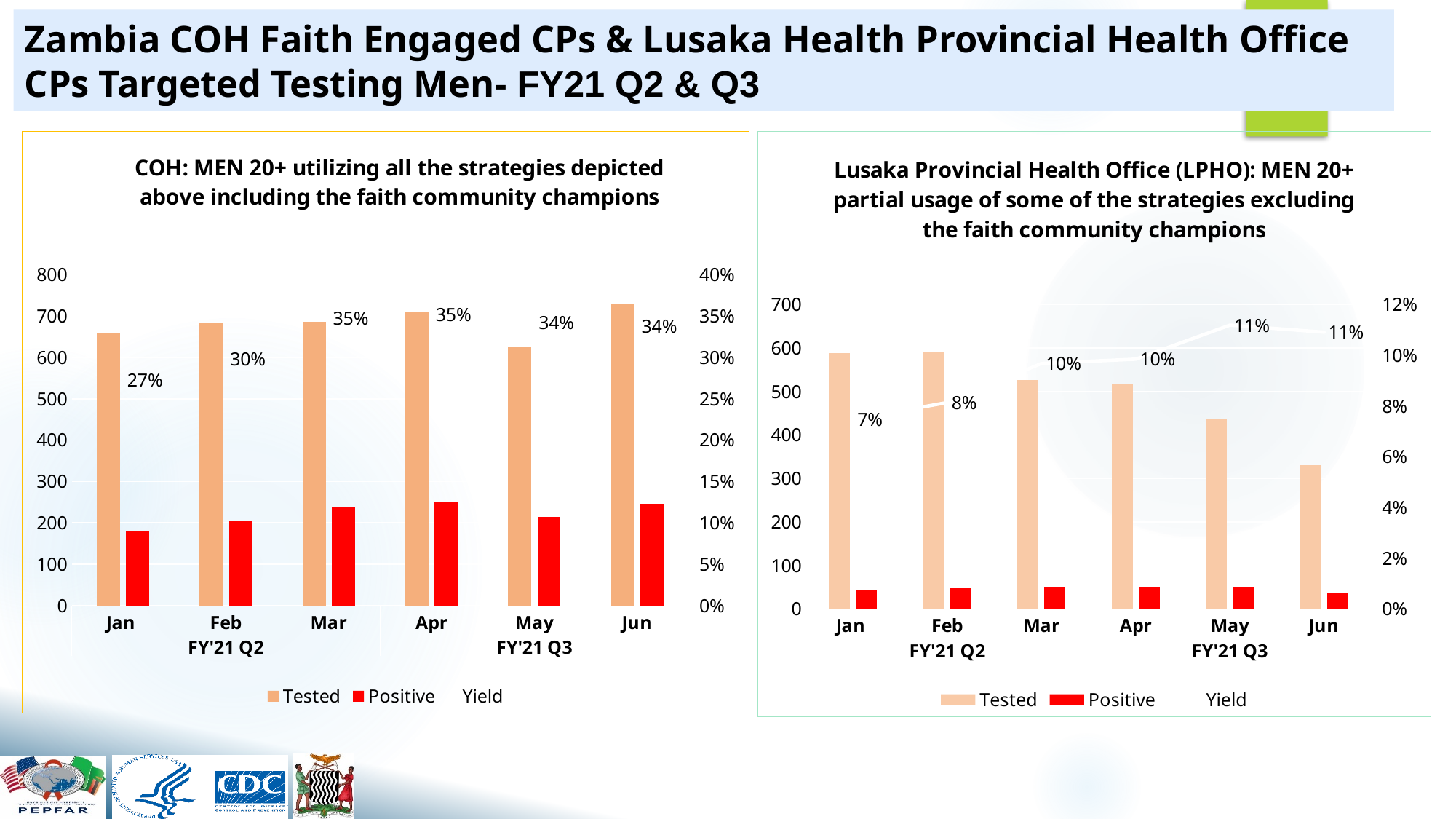
How many series does the legend of the COH chart on the left list? 3 In the COH chart on the left, is the Tested value for Jun greater or less than 700? greater In the LPHO chart on the right, which month has the larger Tested value, Jan or Jun? Jan In the LPHO chart on the right, is the Tested value for Jun greater or less than 400? less In the COH chart on the left, which month has the lowest Yield? Jan In the LPHO chart on the right, do the Tested bars rise or fall from Jan to Jun? fall In the LPHO chart on the right, what is the Yield for May? 11% In the COH chart on the left, what is the Yield for Mar? 35% In the Lusaka Provincial Health Office (LPHO) chart on the right, what is the Yield for Jan? 7% In the COH chart on the left, by how many percentage points does the Yield in Feb exceed the Yield in Jan? 3 percentage points In the LPHO chart on the right, which month has the lowest Yield? Jan In the COH chart on the left, what is the Yield for Jan? 27%